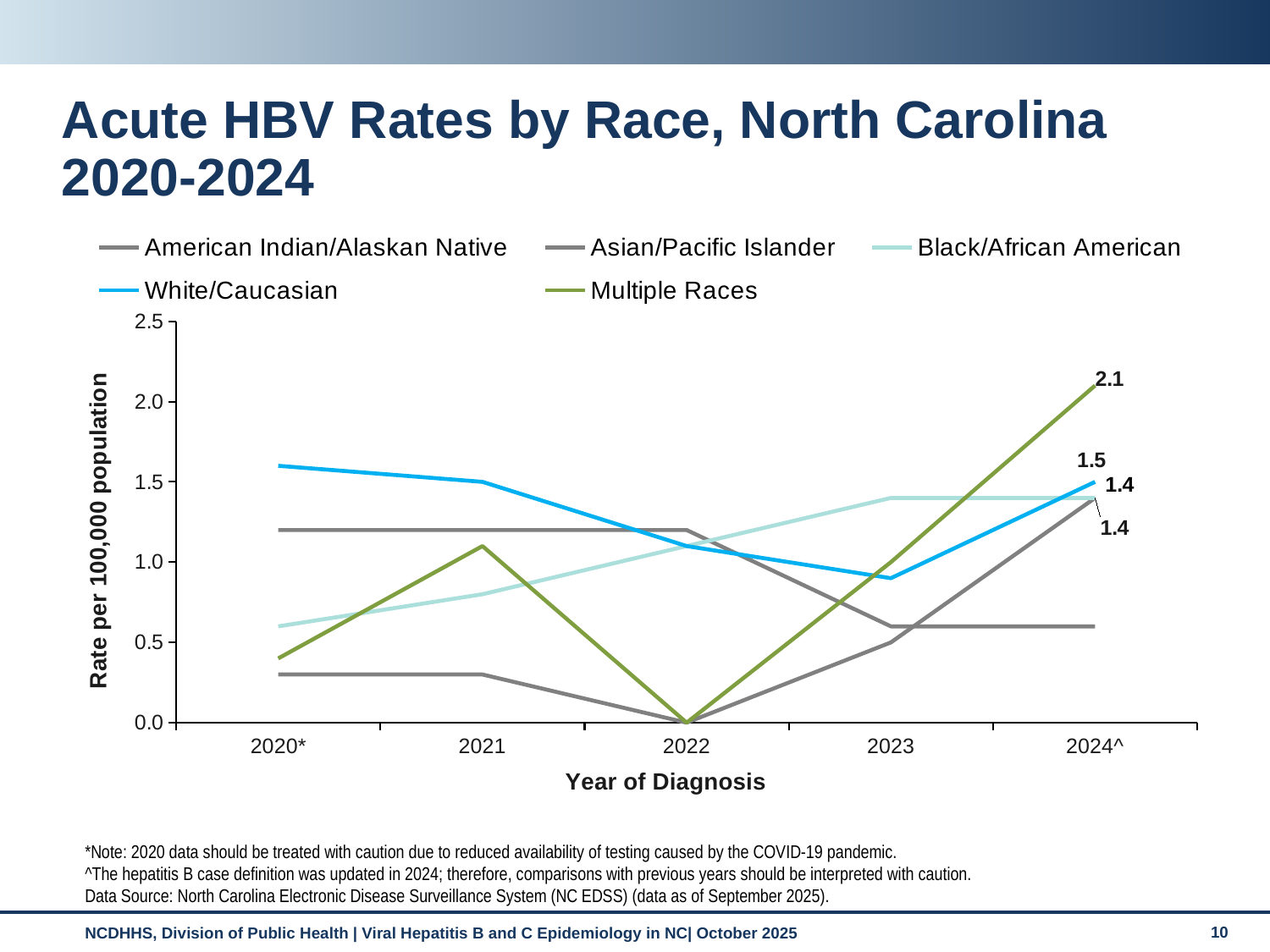
Is the value for Black/African American in 2020 greater or less than 1.0? less What type of chart is shown on the slide? line chart What is the rate for Black/African American in 2024? 1.4 Is the value for Multiple Races in 2022 greater or less than 0.5? less How many years are shown on the x axis? 5 How many series does the legend list? 5 Does the White/Caucasian rate rise or fall from 2020 to 2023? fall What is the difference between the Multiple Races rate and the White/Caucasian rate in 2024? 0.6 What is the title of the y axis? Rate per 100,000 population What is the rate for Multiple Races in 2024? 2.1 Which race group has the highest rate in 2024? Multiple Races What is the rate for White/Caucasian in 2024? 1.5